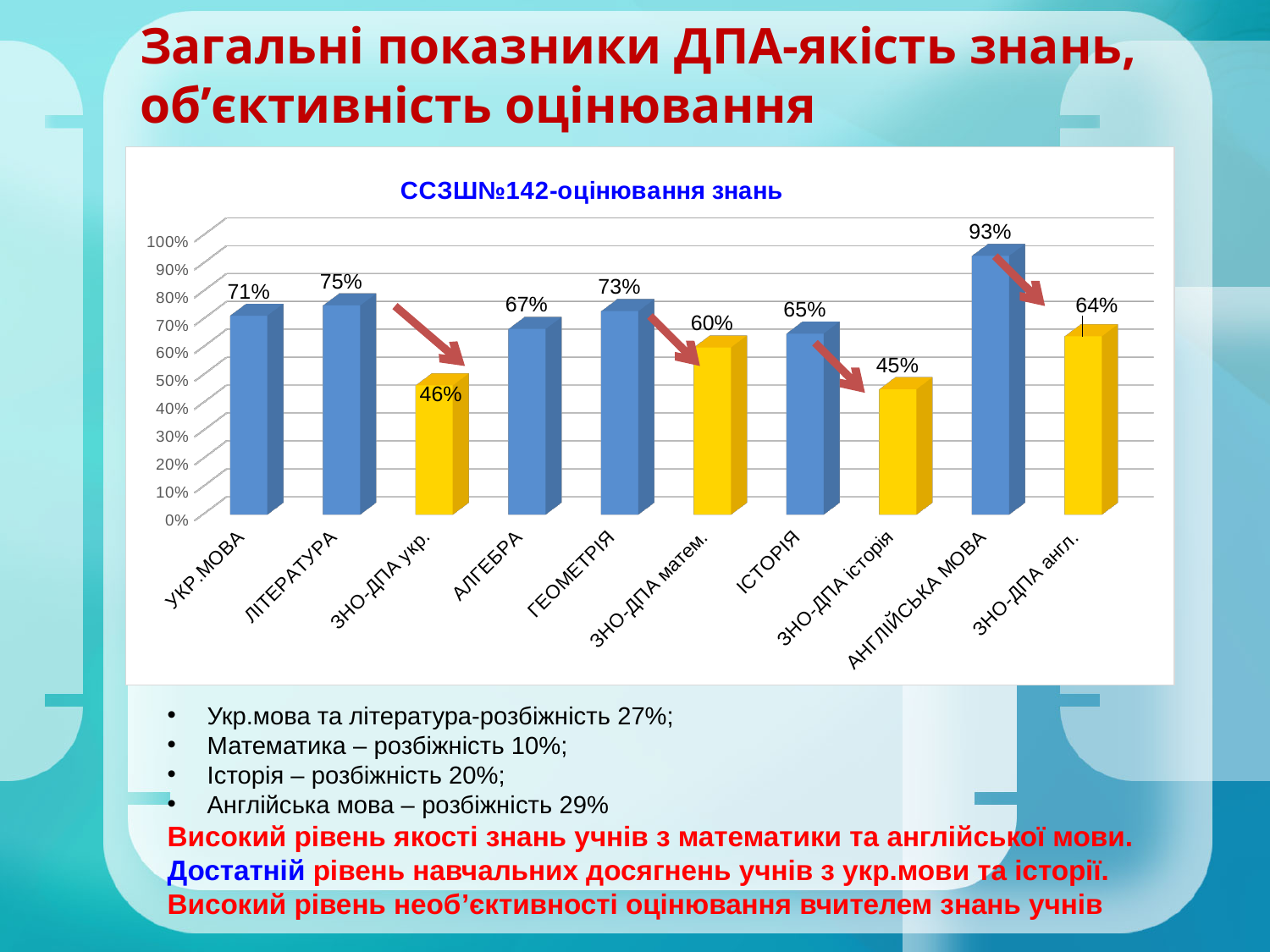
What is the value for УКР.МОВА? 71% Which is larger, the value for ЛІТЕРАТУРА or the value for АЛГЕБРА? ЛІТЕРАТУРА Which category has the highest value? АНГЛІЙСЬКА МОВА Which category has the lowest value? ЗНО-ДПА історія What is the title of the chart? ССЗШ№142-оцінювання знань How many categories are shown on the x axis? 10 What is the value for ГЕОМЕТРІЯ? 73% What is the difference between the values for ІСТОРІЯ and ЗНО-ДПА історія? 20% What type of chart is shown on the slide? bar chart What is the value for ЗНО-ДПА англ.? 64% What is the value for ЗНО-ДПА укр.? 46% What is the difference between the values for АНГЛІЙСЬКА МОВА and ЗНО-ДПА англ.? 29%